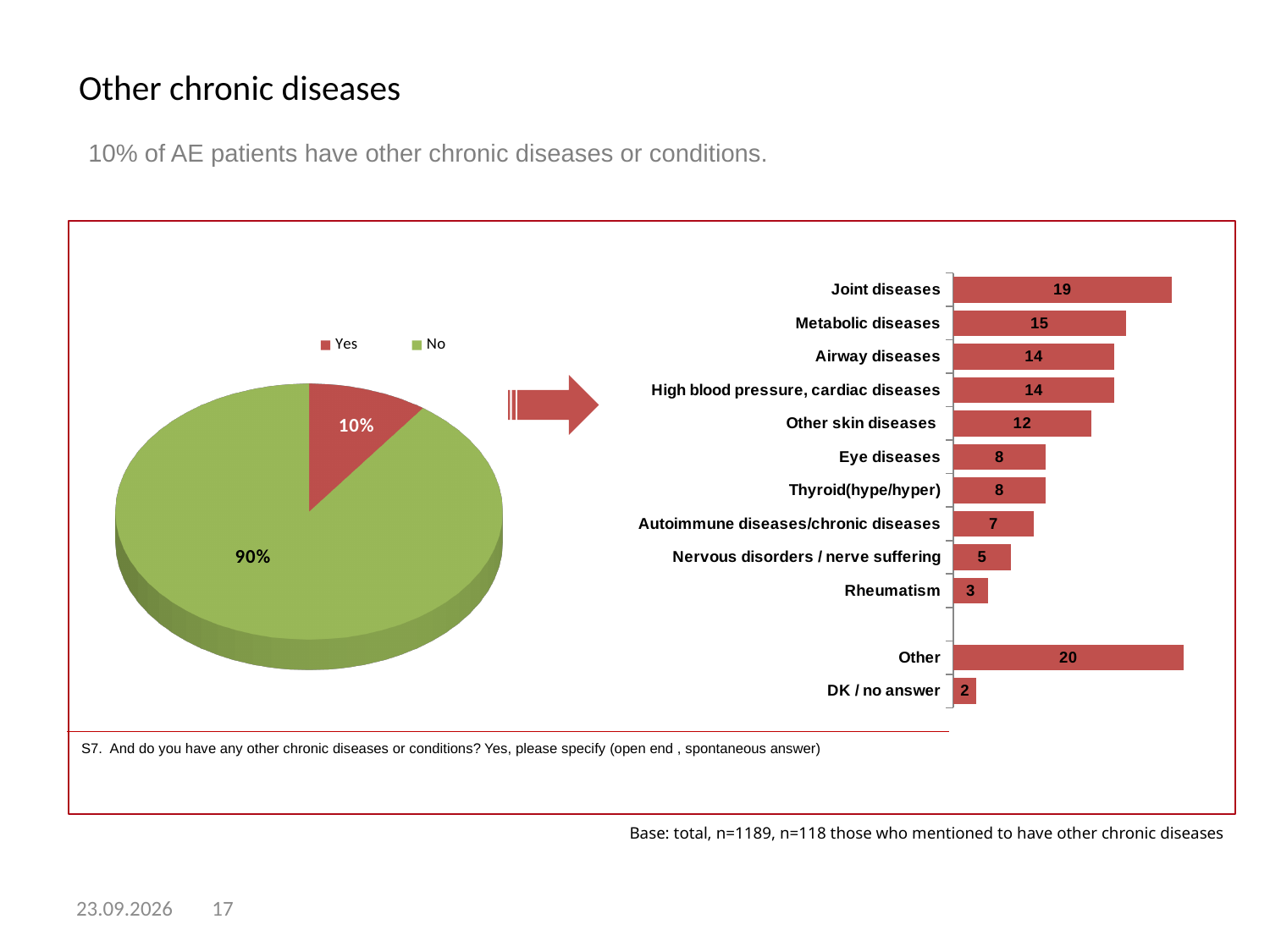
In the pie chart on the left, what share of AE patients answered Yes to having other chronic diseases? 10% How many categories are shown in the bar chart on the right? 12 What kind of chart is the chart on the right side of the slide? Bar chart In the bar chart on the right, what is the difference between Joint diseases and Metabolic diseases? 4 In the pie chart on the left, what share of AE patients answered No? 90% In the bar chart on the right, which is larger: Eye diseases or Nervous disorders / nerve suffering? Eye diseases In the bar chart on the right, what is the value for Joint diseases? 19 In the bar chart on the right, which category has the lowest value? DK / no answer How many entries does the legend of the pie chart on the left list? 2 In the bar chart on the right, what is the value for Other skin diseases? 12 In the bar chart on the right, what is the value for Rheumatism? 3 In the bar chart on the right, which category has the highest value? Other